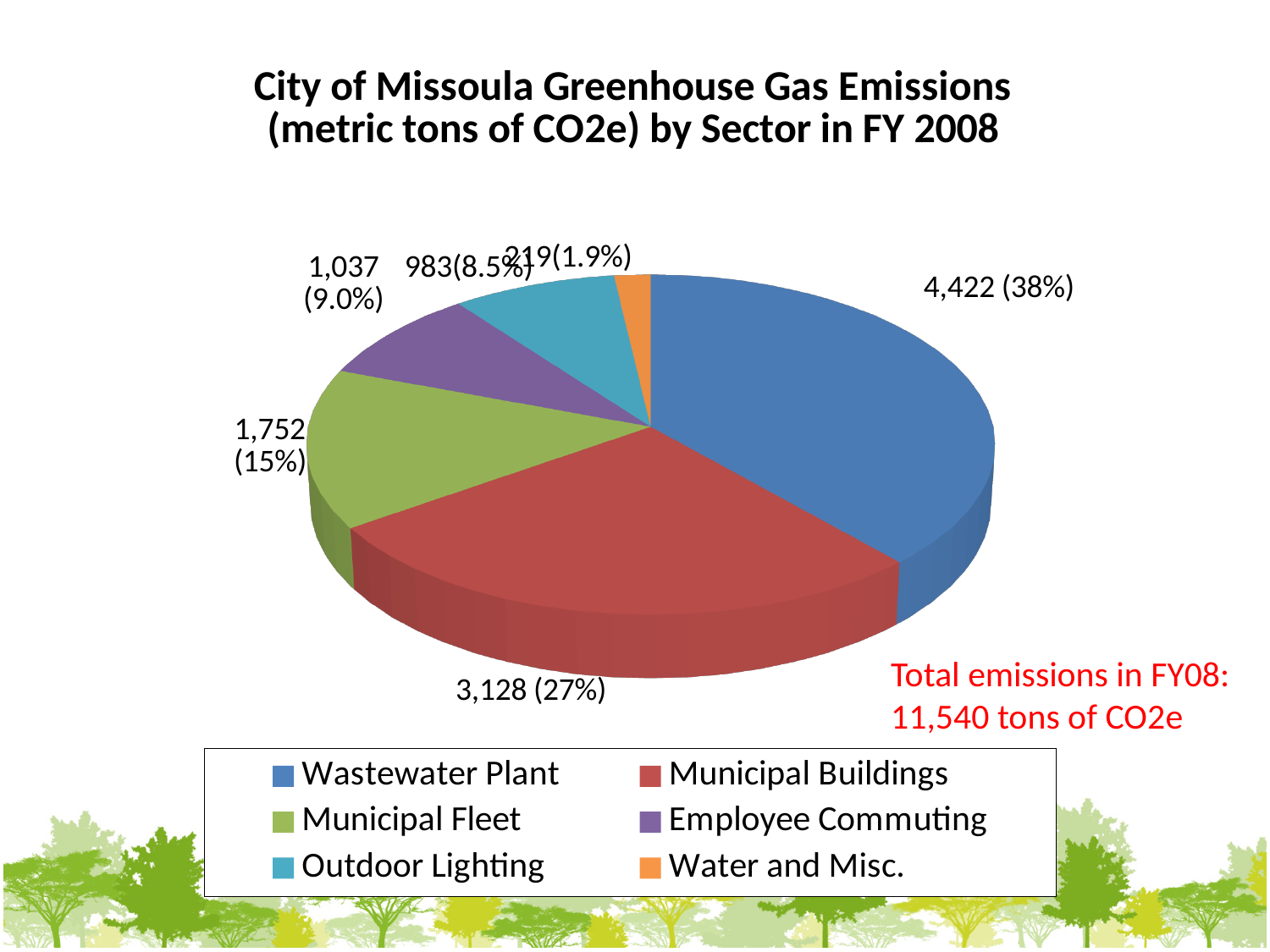
How many sectors does the legend list? 6 What is the value for Municipal Fleet? 1,752 What is the value for Employee Commuting? 1,037 Which is larger, Municipal Fleet or Employee Commuting? Municipal Fleet What is the value for Municipal Buildings? 3,128 What percentage share of the pie does Municipal Buildings have? 27% Which sector has the largest share of emissions? Wastewater Plant What percentage share of the pie does Outdoor Lighting have? 8.5% Which sector has the smallest share of emissions? Water and Misc. What kind of chart is shown on the slide? Pie chart What is the value for Wastewater Plant? 4,422 What is the difference between the Wastewater Plant and Municipal Buildings values? 1,294